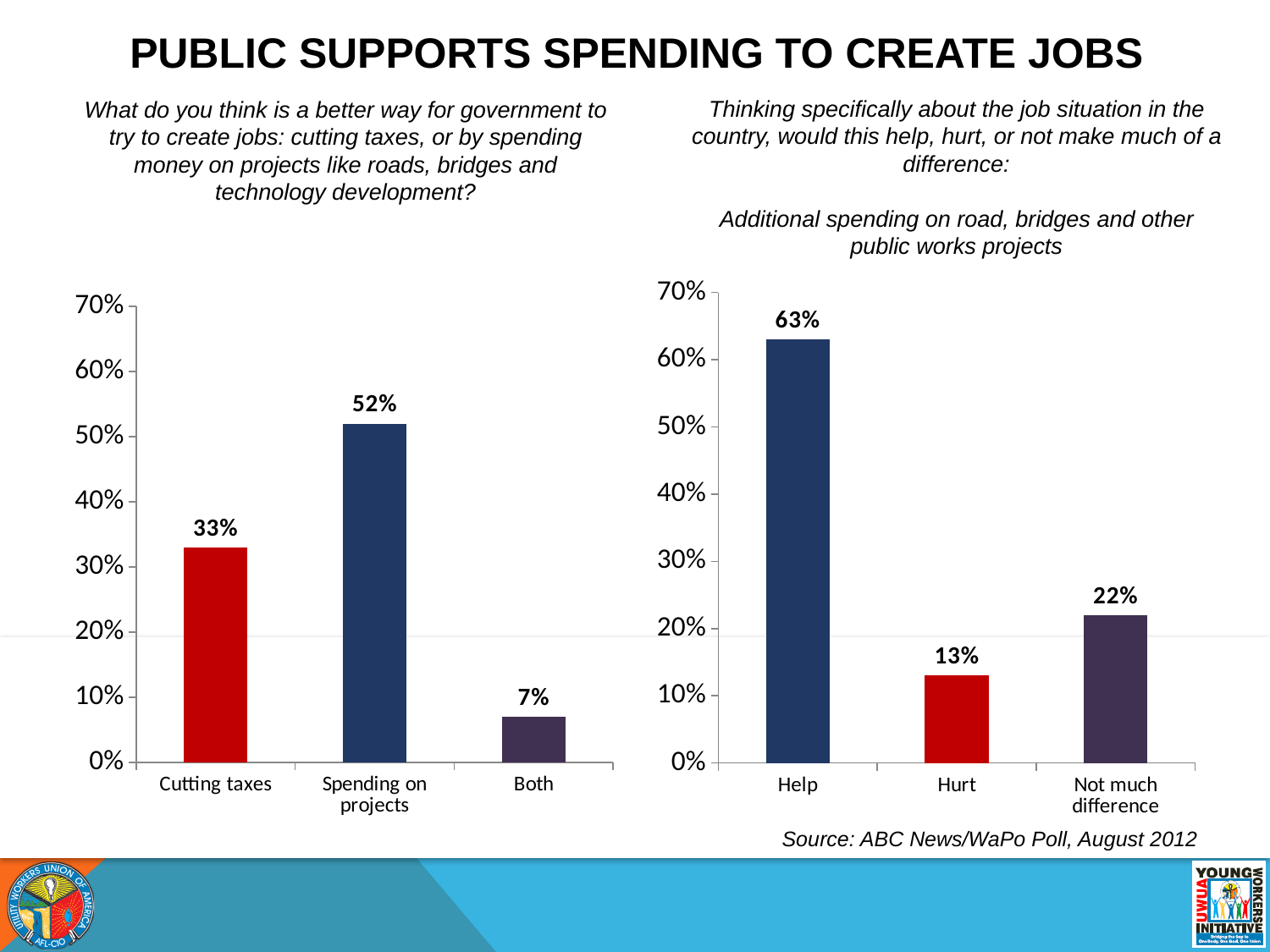
In the right chart, what percentage said 'Not much difference'? 22% In the left chart, which category has the lowest value? Both In the left chart, what is the difference between 'Spending on projects' and 'Cutting taxes'? 19% In the right chart, which is larger: 'Hurt' or 'Not much difference'? Not much difference What type of chart is the right chart? Bar chart In the right chart, what percentage said additional spending on public works projects would 'Help'? 63% In the right chart, which category has the highest value? Help In the left chart, what percentage chose 'Cutting taxes'? 33% What is the source cited for the data on the slide? ABC News/WaPo Poll, August 2012 In the left chart, what percentage chose 'Spending on projects'? 52% In the right chart, what is the difference between 'Help' and 'Hurt'? 50% How many categories are shown in the left chart? 3